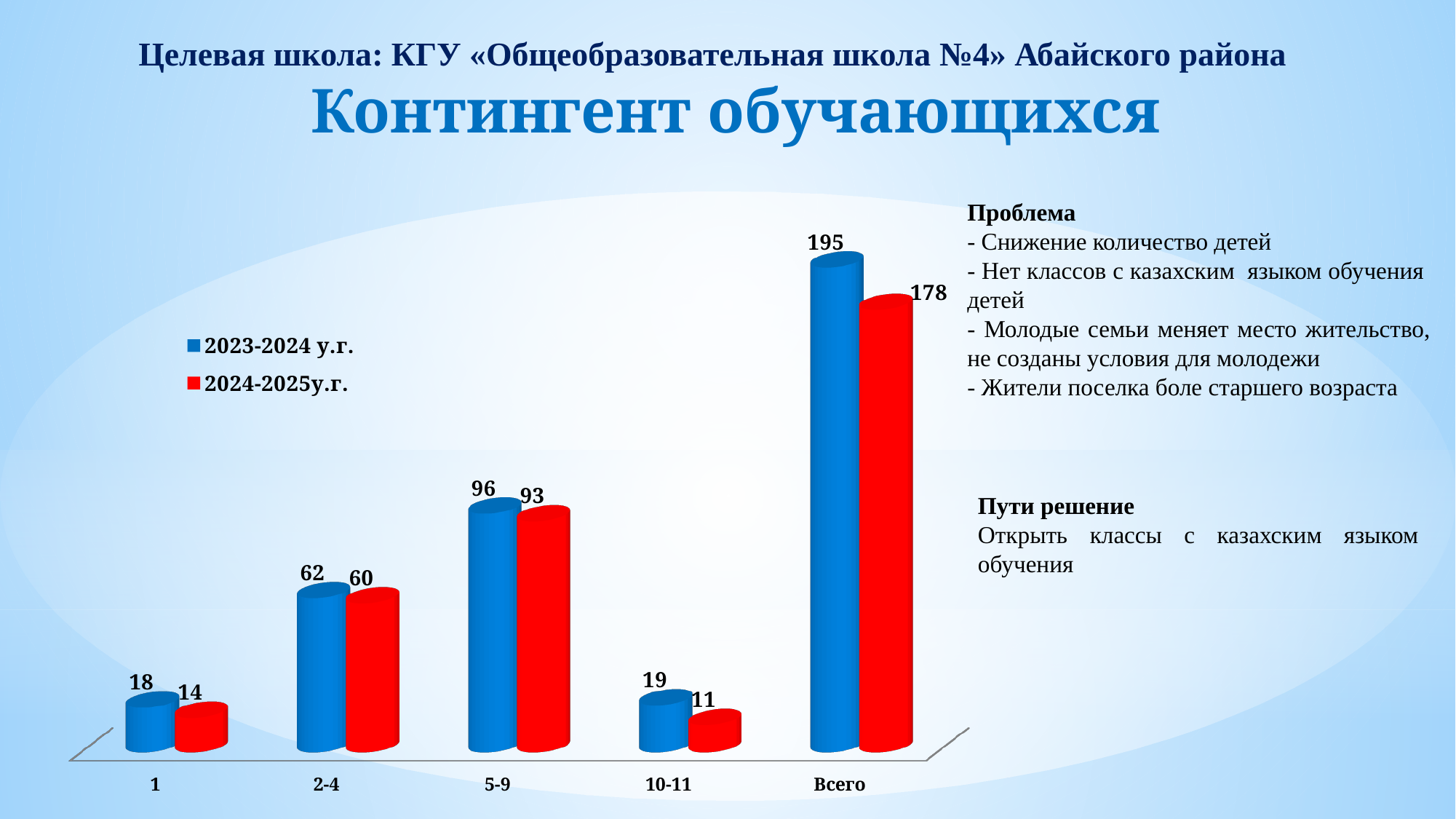
How many categories are shown on the x axis? 5 What kind of chart is shown on the slide? Bar chart What is the value for Всего in the 2024-2025у.г. series? 178 How many series does the legend list? 2 What is the value for category 1 in the 2023-2024 у.г. series? 18 Which category has the highest value in the 2023-2024 у.г. series? Всего What is the difference between the 2023-2024 у.г. and 2024-2025у.г. values for Всего? 17 What is the value for category 5-9 in the 2023-2024 у.г. series? 96 What is the difference between the 2023-2024 у.г. and 2024-2025у.г. values for category 2-4? 2 Which is larger for category 10-11: the 2023-2024 у.г. value or the 2024-2025у.г. value? 2023-2024 у.г. What is the value for category 10-11 in the 2024-2025у.г. series? 11 Which category has the lowest value in the 2024-2025у.г. series? 10-11